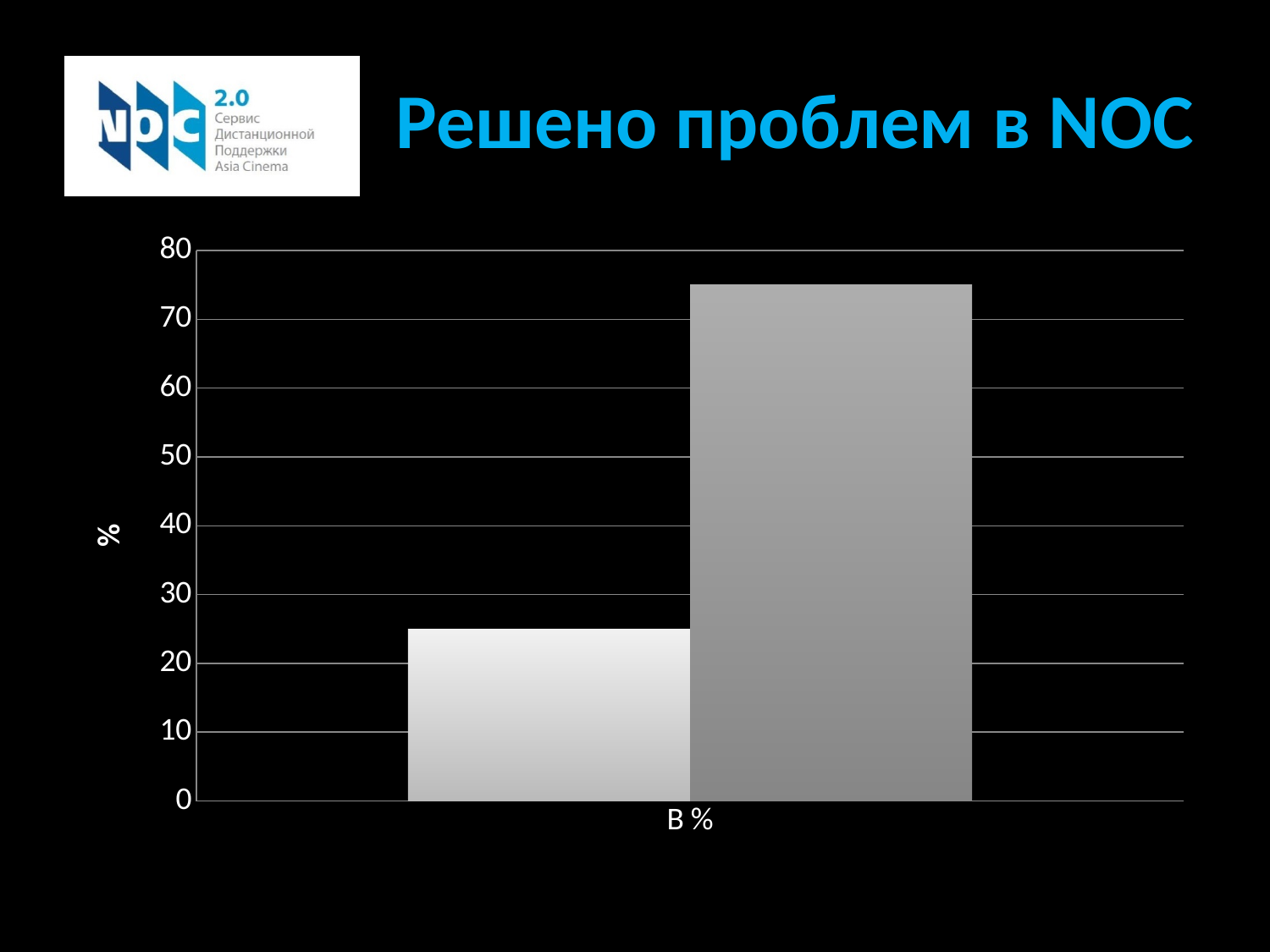
Is the value of the left light grey bar greater or less than 30? less Is the value of the right dark grey bar greater or less than 80? less How many bars are plotted in the chart? 2 Is the value of the right dark grey bar greater or less than 70? greater What is the highest value shown on the vertical axis of the chart? 80 What is the label on the vertical axis of the chart? % What is the title of the chart on the slide? Решено проблем в NOC What kind of chart is shown on the slide? bar chart Which bar is taller, the left light grey bar or the right dark grey bar? the right dark grey bar